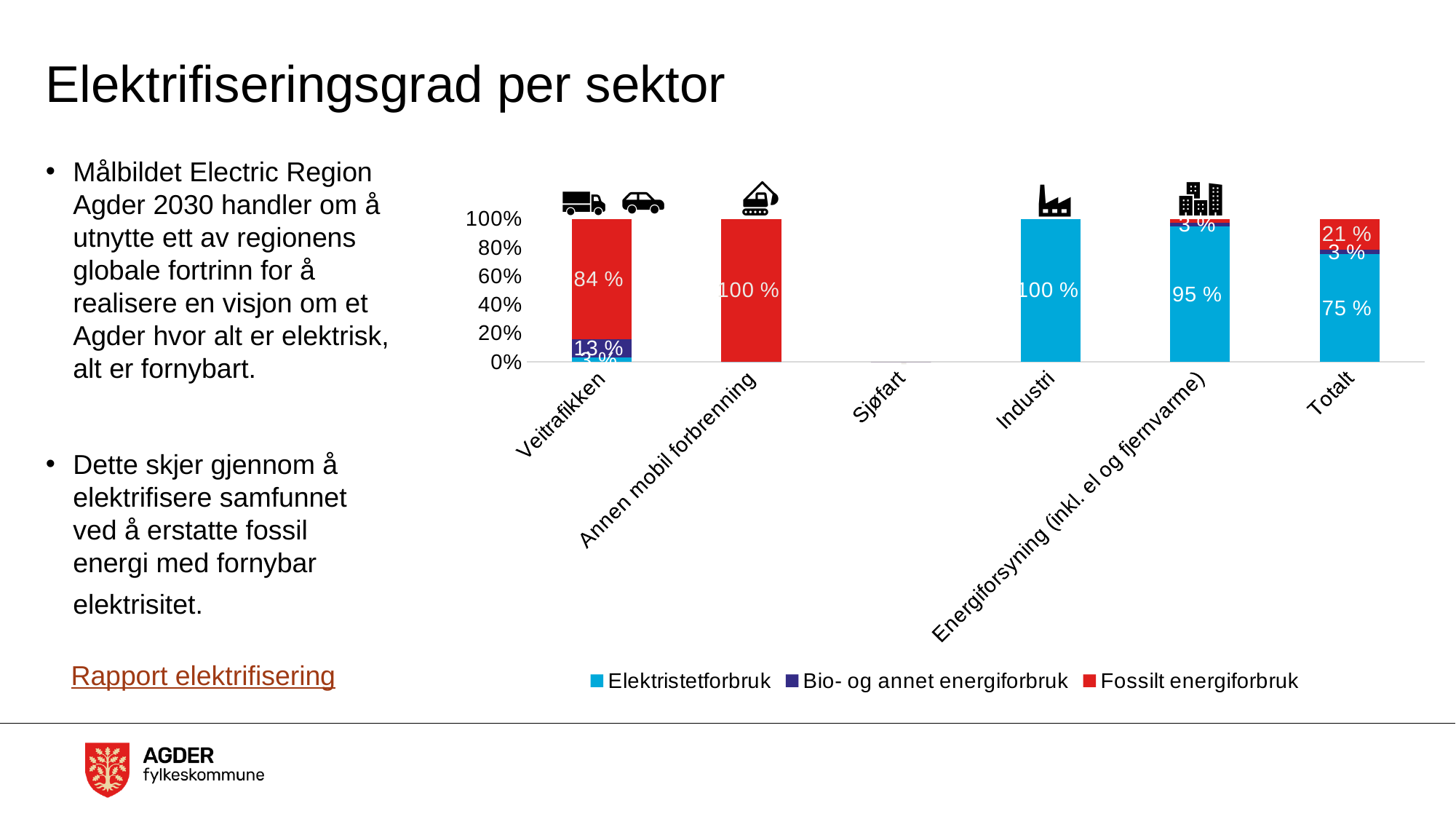
What is the Fossilt energiforbruk share for Veitrafikken? 84 % What is the Elektristetforbruk share for Totalt? 75 % What is the Bio- og annet energiforbruk share for Veitrafikken? 13 % What kind of chart is shown on the slide? Stacked bar chart What is the Elektristetforbruk share for Industri? 100 % Which series is shown in red in the chart? Fossilt energiforbruk How many categories are shown along the x axis of the chart? 6 What is the Fossilt energiforbruk share for Annen mobil forbrenning? 100 % What is the Fossilt energiforbruk share for Totalt? 21 % What is the difference in Fossilt energiforbruk share between Veitrafikken and Totalt? 63 percentage points Which has the larger Elektristetforbruk share, Energiforsyning (inkl. el og fjernvarme) or Totalt? Energiforsyning (inkl. el og fjernvarme) How many series does the chart legend list? 3